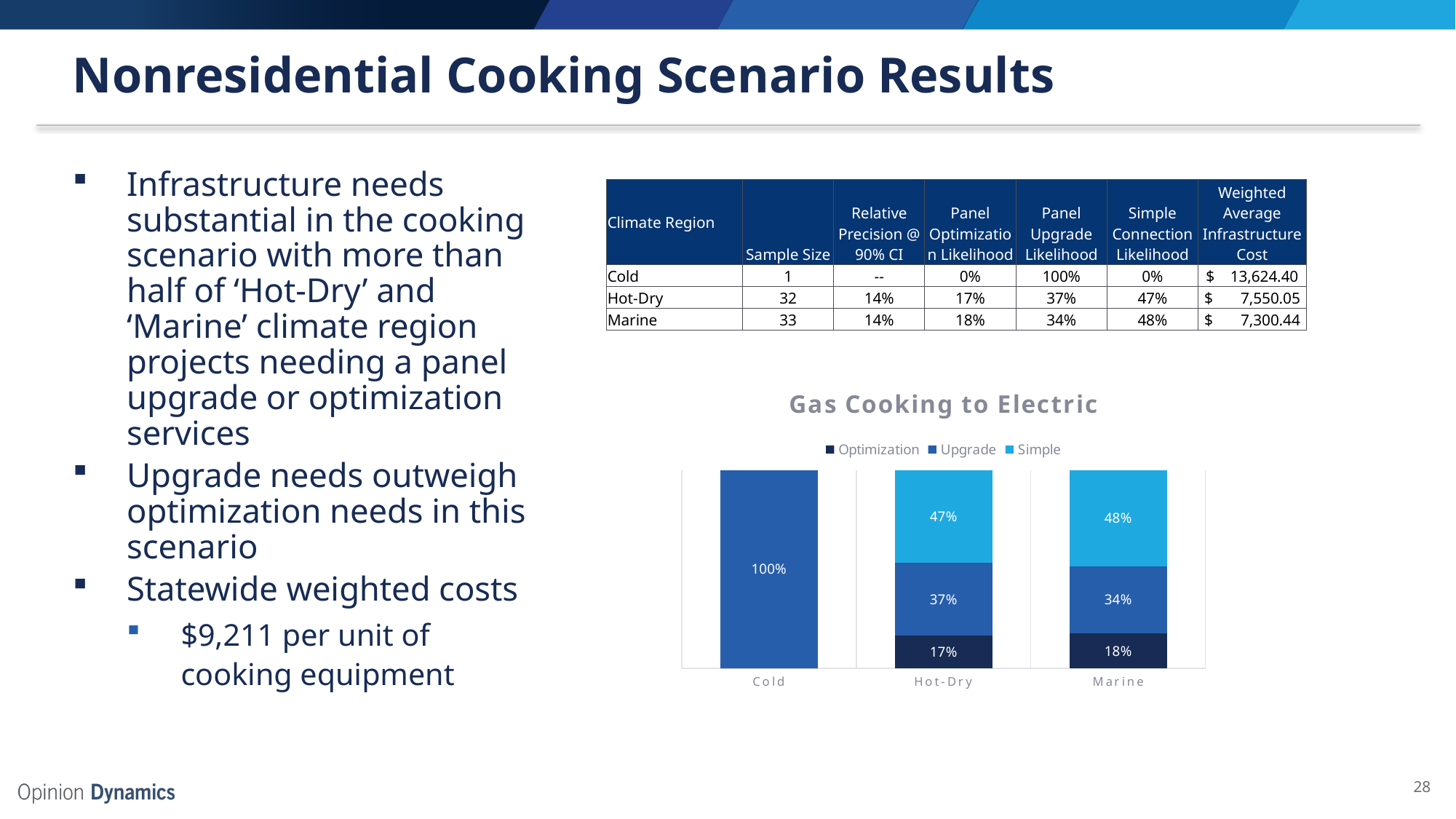
What is the total of the stacked bar for Hot-Dry? 101% What is the Upgrade value for Cold? 100% What is the difference between the Simple and Optimization values for Marine? 30% What is the Upgrade value for Hot-Dry? 37% Which category has the highest Optimization value? Marine What is the title of the chart? Gas Cooking to Electric What is the Optimization value for Hot-Dry? 17% How many climate region categories are shown on the x axis? 3 What is the Simple value for Marine? 48% Is the Upgrade value larger for Hot-Dry or for Marine? Hot-Dry How many series does the legend list? 3 What kind of chart is shown? stacked bar chart